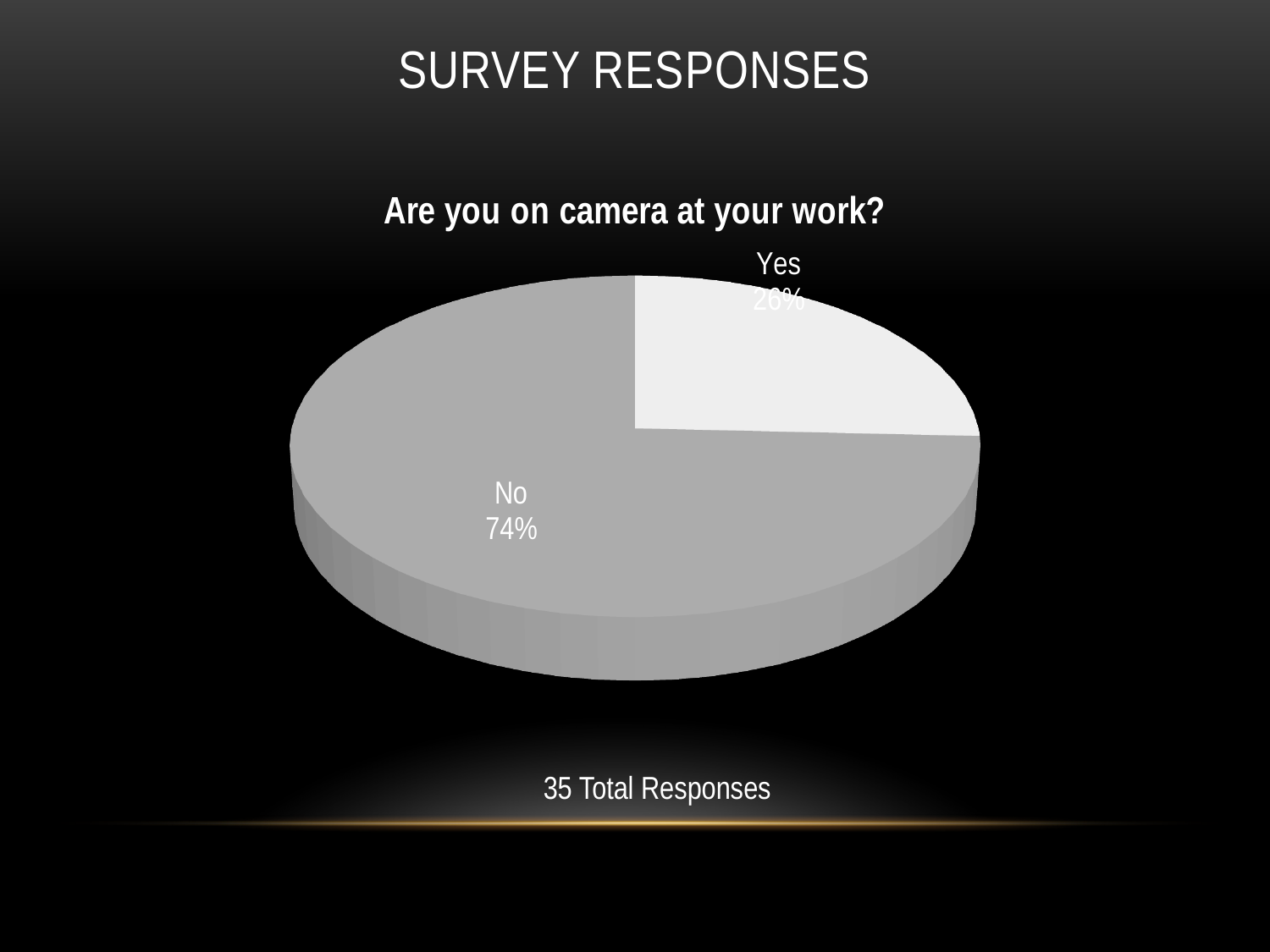
What share of the pie is labelled "Yes"? 26% What kind of chart is shown on the slide? pie chart Which slice of the pie is the largest? No What is the title of the chart? Are you on camera at your work? What share of the pie is labelled "No"? 74% How many total responses does the slide report for the survey? 35 How many slices does the pie chart have? 2 Which slice of the pie is the smallest? Yes What is the difference in percentage points between the "No" and "Yes" slices? 48 Which is larger, the "Yes" slice or the "No" slice? No